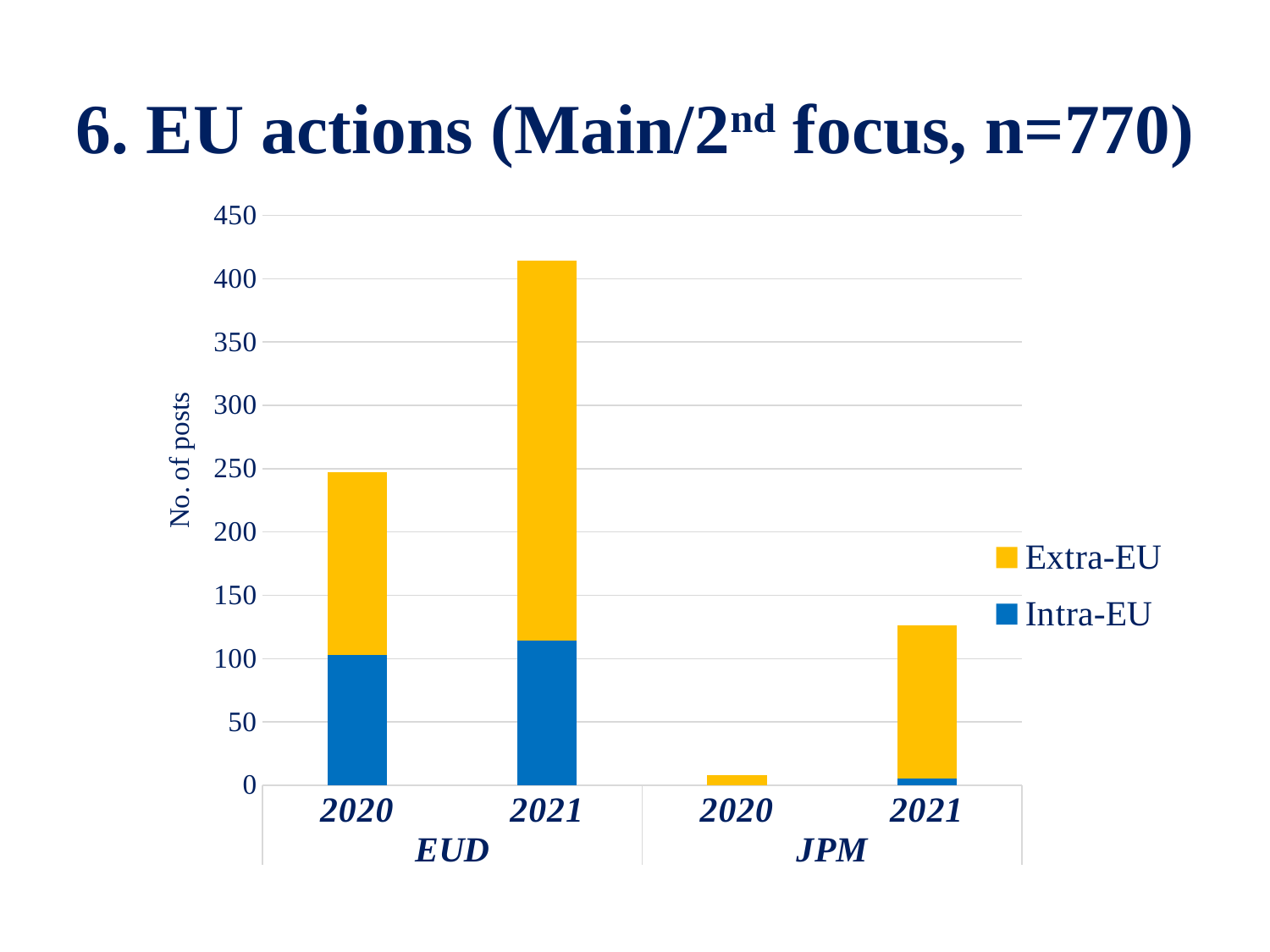
Which bar has the highest total number of posts? EUD 2021 Which bar has the lowest total number of posts? JPM 2020 Which is larger, the total for EUD 2020 or the total for JPM 2021? EUD 2020 Is the total for EUD 2021 greater or less than 400? greater What are the two series named in the legend? Extra-EU and Intra-EU Is the total for JPM 2021 greater or less than 100? greater How many bars are plotted in the chart? 4 What is the label of the vertical axis? No. of posts How many series does the legend list? 2 What kind of chart is shown on the slide? stacked bar chart